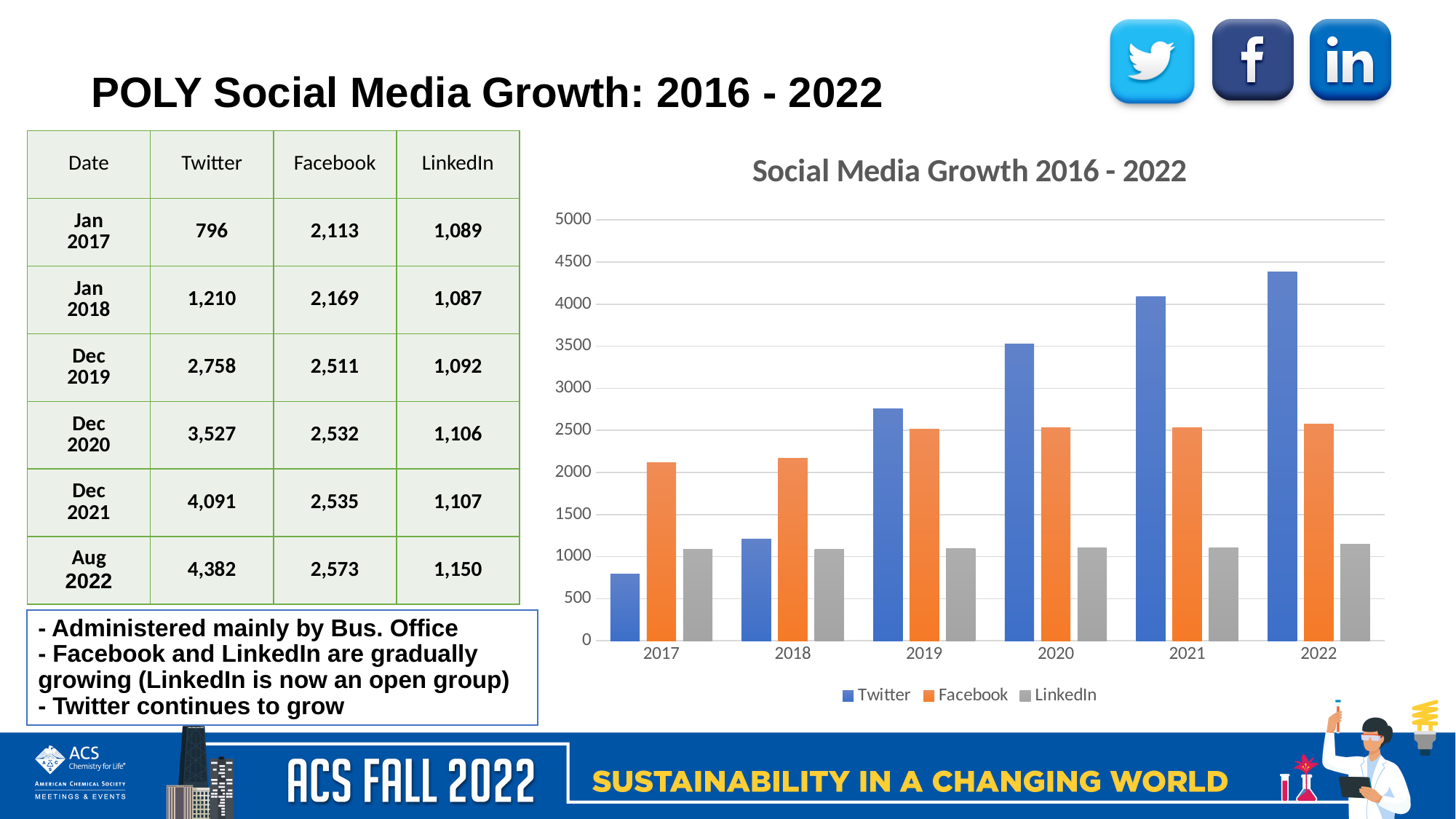
Is the LinkedIn value for 2020 greater or less than 1500? less How many years are shown on the x axis of the chart? 6 How many series does the chart legend list? 3 According to the slide, what is the Twitter value for Aug 2022? 4,382 Do the Twitter values rise or fall from 2017 to 2022? rise In 2018, which is larger, the Twitter bar or the Facebook bar? Facebook What is the title of the chart? Social Media Growth 2016 - 2022 Is the Twitter value for 2021 greater or less than 4000? greater What type of chart is shown on the slide? bar chart Is the Facebook value for 2019 greater or less than 3000? less Which series has the tallest bar in 2022? Twitter Which series has the lowest bar in 2017? Twitter